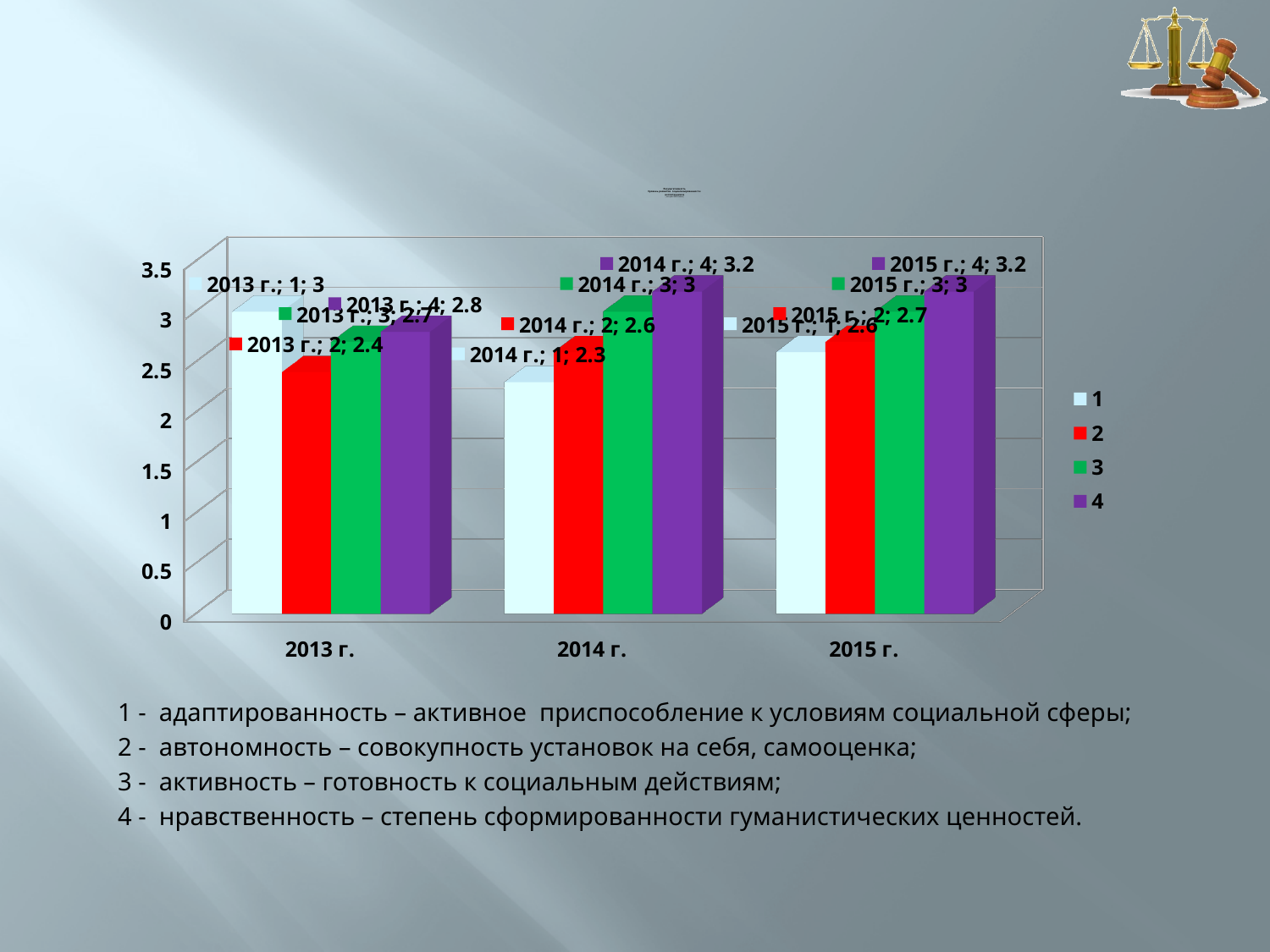
What kind of chart is shown on the slide? bar chart How many year categories are shown on the x axis? 3 What is the difference between series 4 and series 1 in 2014 г.? 0.9 What is the value for series 4 in 2014 г.? 3.2 How many series does the legend list? 4 Which series has the highest value in 2015 г.? 4 Does the value for series 1 rise or fall from 2013 г. to 2014 г.? fall What is the value for series 2 in 2015 г.? 2.7 Which series has the lowest value in 2013 г.? 2 What is the value for series 1 in 2014 г.? 2.3 What is the value for series 1 in 2013 г.? 3 Which is larger: series 3 in 2013 г. or series 3 in 2014 г.? series 3 in 2014 г.